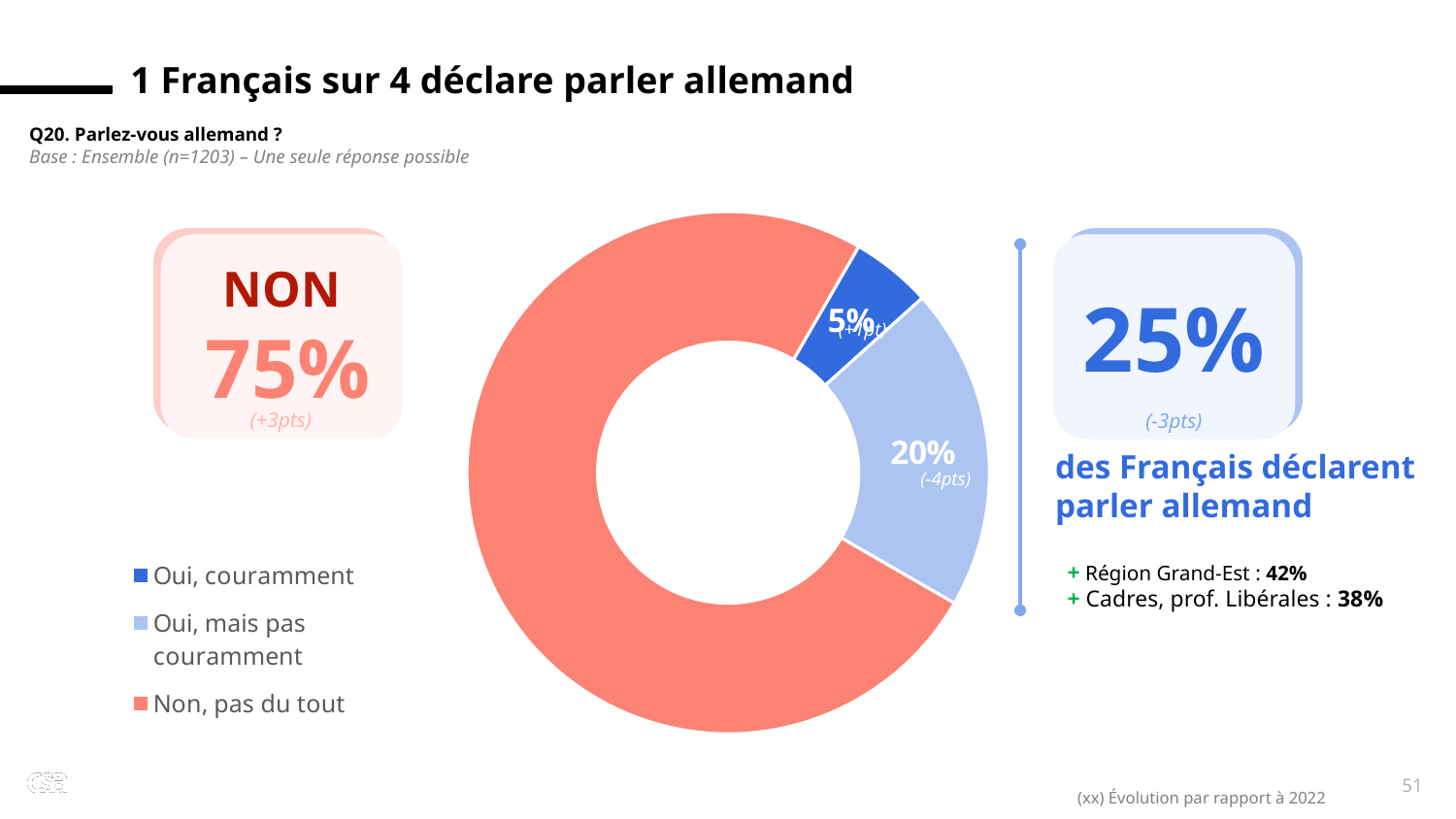
What share of respondents answered "Non, pas du tout"? 75% Which is larger: the slice for "Oui, mais pas couramment" or the slice for "Oui, couramment"? Oui, mais pas couramment What is the value for "Oui, couramment"? 5% What is the difference between the "Oui, mais pas couramment" and "Oui, couramment" values? 15% What is the title of the slide containing the chart? 1 Français sur 4 déclare parler allemand What kind of chart is shown on the slide? Pie chart (donut) What colour is the "Non, pas du tout" slice? Red (salmon) How many categories does the legend of the chart list? 3 What is the value for "Oui, mais pas couramment"? 20% What is the combined share of the two "Oui" categories? 25% Which category has the smallest slice of the chart? Oui, couramment Which category has the largest slice of the chart? Non, pas du tout